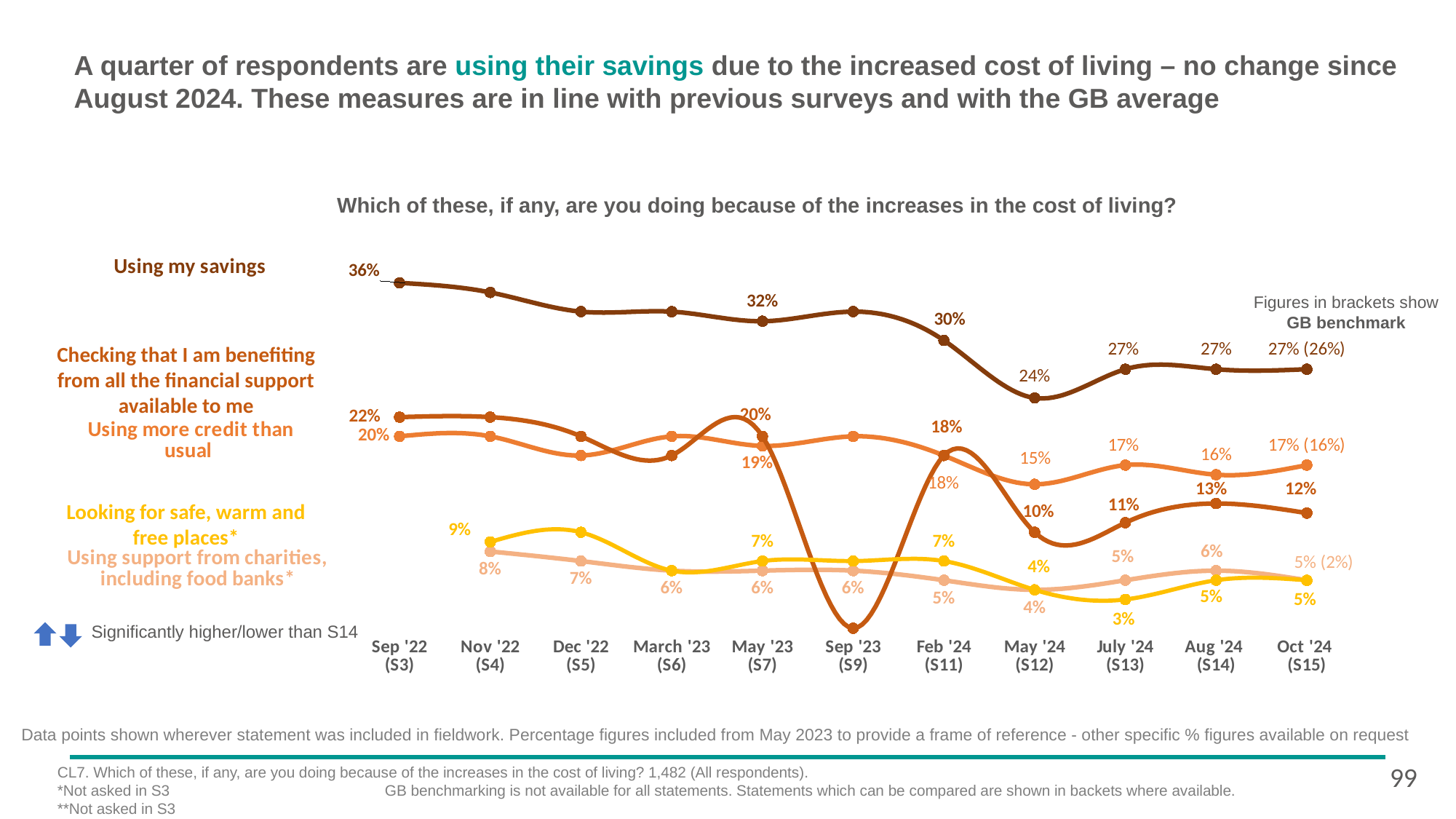
What was the value for 'Checking that I am benefiting from all the financial support available to me' in May '24 (S12)? 10% At which survey wave was 'Using my savings' at its lowest labelled value? May '24 (S12) What was the value for 'Using my savings' in Sep '22 (S3)? 36% How many survey waves are shown on the x axis? 11 What type of chart is used on this slide? Line chart What is the GB benchmark figure shown in brackets for 'Using my savings'? 26% What percentage were 'Using more credit than usual' in Oct '24 (S15)? 17% What percentage of respondents said they were using their savings in Oct '24 (S15)? 27% By how many percentage points did 'Using my savings' fall between Sep '22 (S3) and Oct '24 (S15)? 9 percentage points Which statement has the highest value in Oct '24 (S15)? Using my savings What was the value for 'Looking for safe, warm and free places' in July '24 (S13)? 3% In Oct '24 (S15), which is larger: 'Using more credit than usual' or 'Checking that I am benefiting from all the financial support available to me'? Using more credit than usual